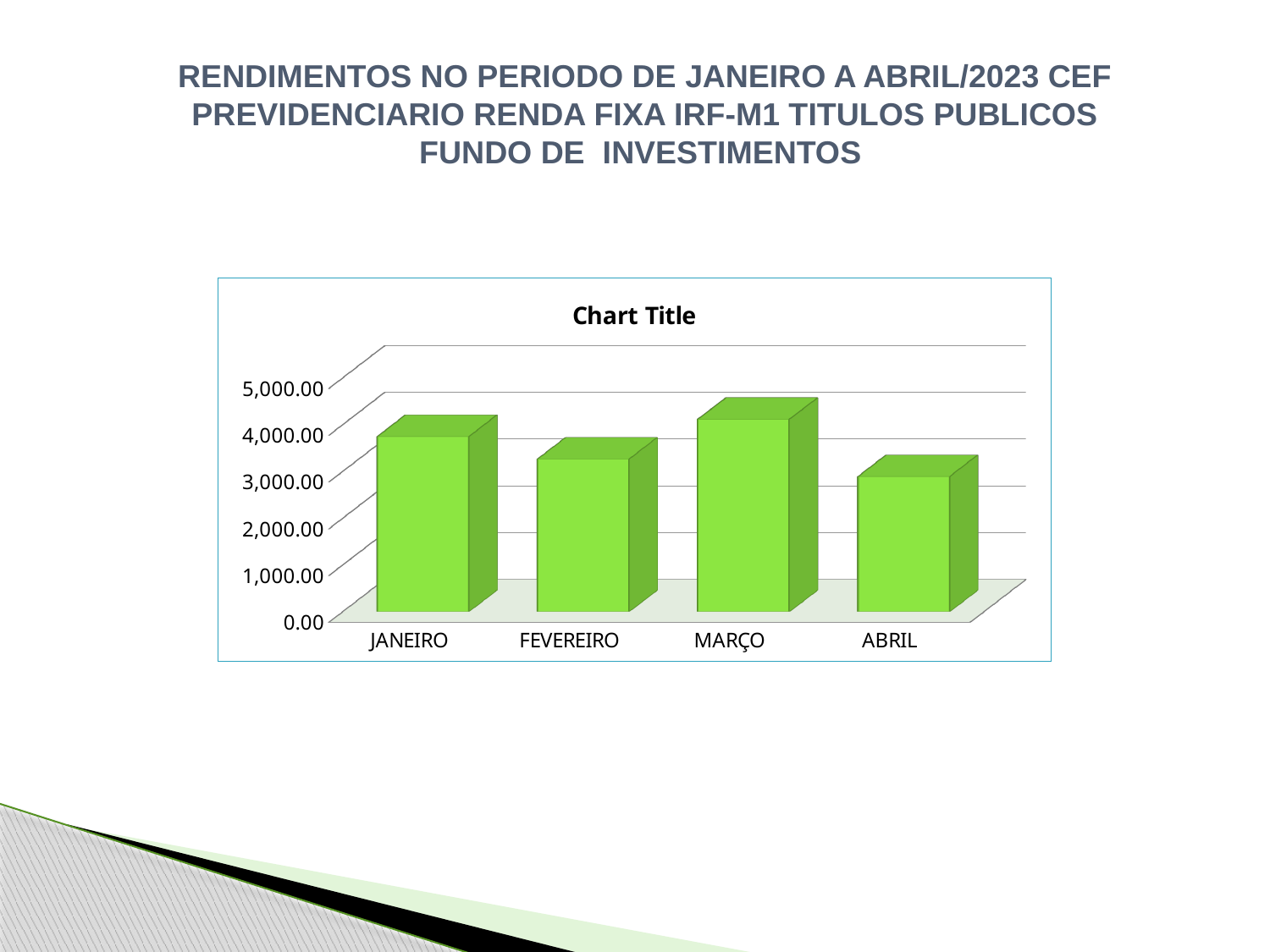
Is the value for MARÇO greater or less than 5,000.00? less Is the value for ABRIL greater or less than 4,000.00? less Which is larger, the value for JANEIRO or the value for FEVEREIRO? JANEIRO Which month has the highest bar in the chart? MARÇO Which is larger, the value for MARÇO or the value for ABRIL? MARÇO How many categories are plotted on the x axis of the chart? 4 Is the value for JANEIRO greater or less than 3,000.00? greater Which month has the lowest bar in the chart? ABRIL What kind of chart is shown on the slide? bar chart Does the value rise or fall from MARÇO to ABRIL? fall What title is printed above the plot area of the chart? Chart Title